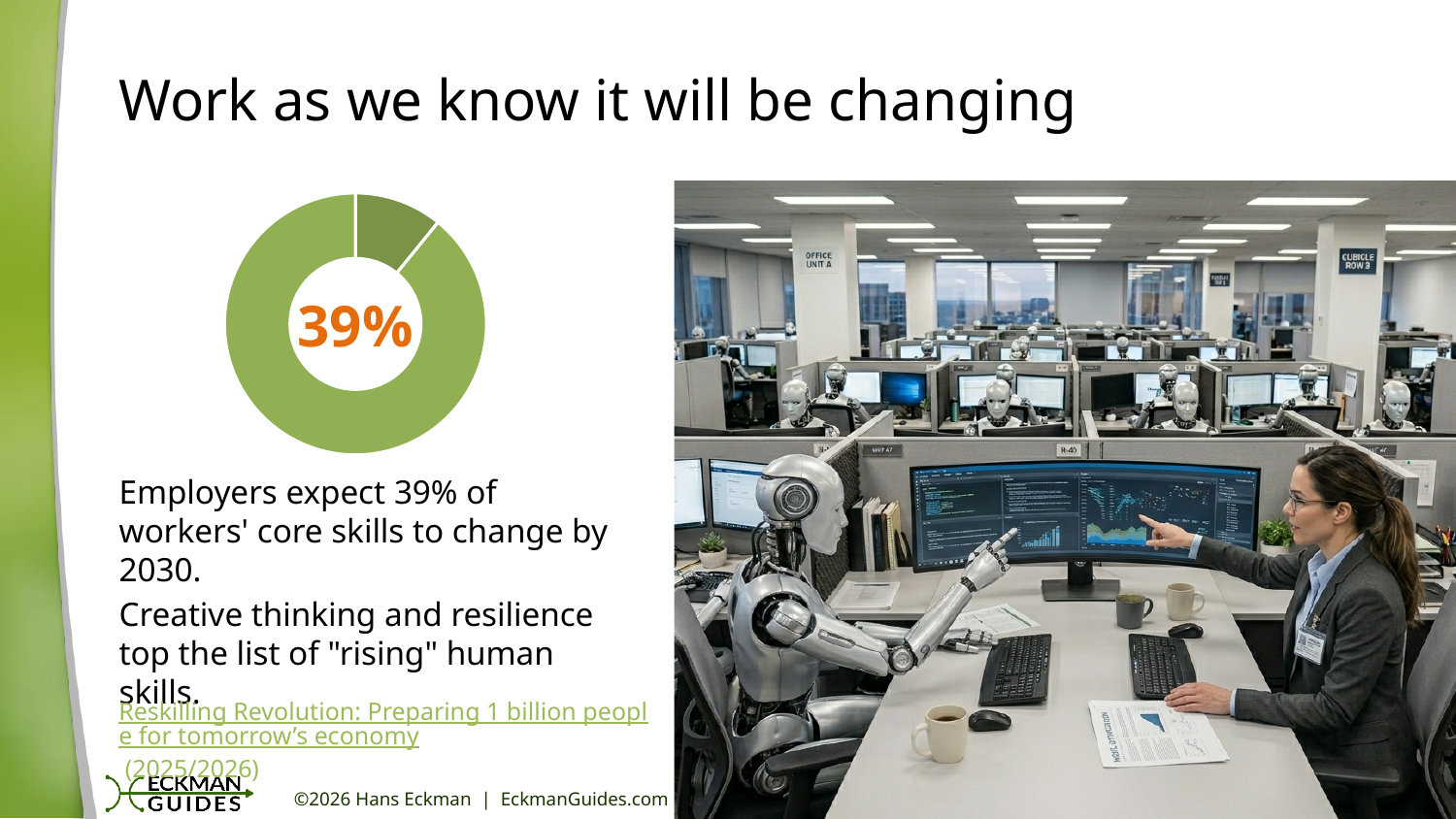
What kind of chart is shown on the left of the slide? Donut (pie) chart Which slice of the donut chart is larger, the light green one or the dark green one? Light green What value is printed in the center of the donut chart? 39% What colour is the value label in the center of the donut chart? Orange Does the dark green slice of the donut chart cover more or less than half of the ring? Less According to the slide, what share of workers' core skills do employers expect to change by 2030? 39% Does the donut chart have a legend? No How many slices does the donut chart have? 2